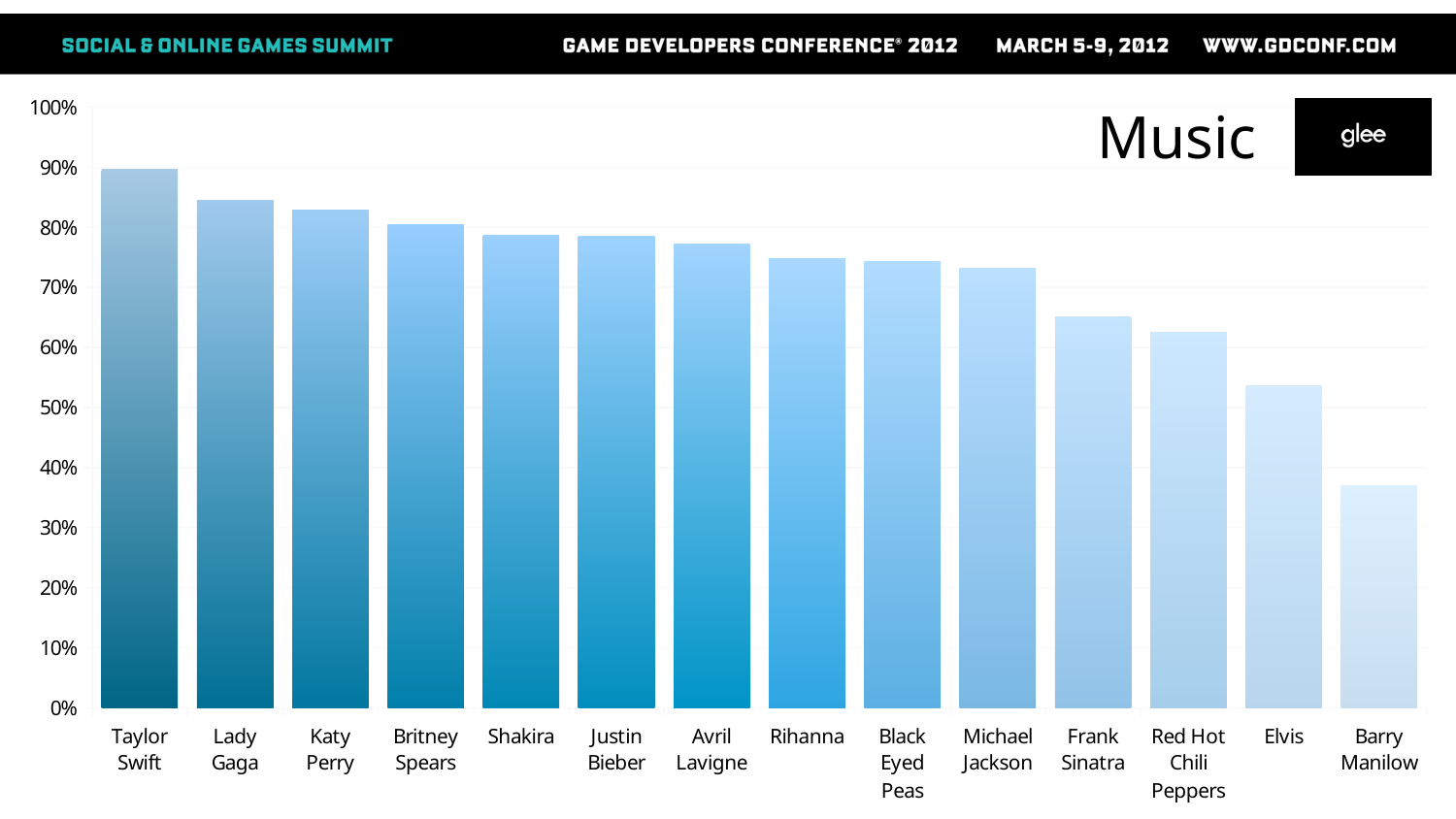
Is the value for Elvis greater or less than 50%? greater Which artist has the highest value in the chart? Taylor Swift Is the value for Rihanna greater or less than 80%? less What kind of chart is shown on the slide? Bar chart Is the value for Barry Manilow greater or less than 40%? less Which is larger, the value for Frank Sinatra or the value for Katy Perry? Katy Perry Which artist has the lowest value in the chart? Barry Manilow How many artists are shown on the x axis of the chart? 14 Which is larger, the value for Lady Gaga or the value for Elvis? Lady Gaga What is the title of the chart? Music Do the values rise or fall moving from left to right along the x axis? Fall